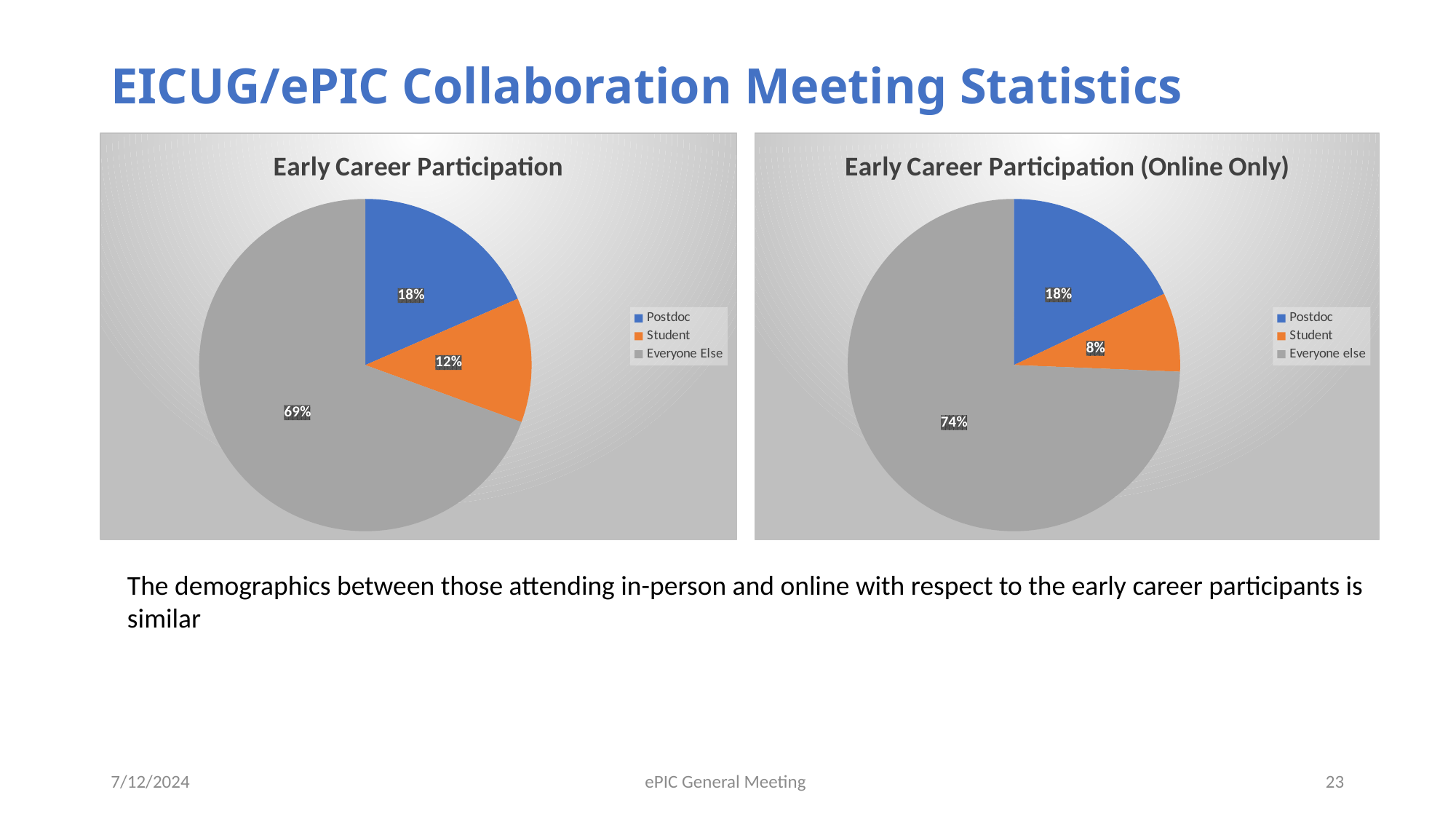
In the 'Early Career Participation' chart, what is the difference between the Postdoc and Student shares? 6% In the 'Early Career Participation' chart, what share of the pie is Student? 12% In the 'Early Career Participation (Online Only)' chart, which is larger, the Postdoc slice or the Student slice? Postdoc In the 'Early Career Participation' chart, what share of the pie is Postdoc? 18% In the 'Early Career Participation (Online Only)' chart, which category has the smallest slice? Student In the 'Early Career Participation' chart, which category has the largest slice? Everyone Else In the 'Early Career Participation (Online Only)' chart, what share of the pie is Everyone else? 74% What kind of chart is the 'Early Career Participation' chart? Pie chart How many categories does the legend of the 'Early Career Participation (Online Only)' chart list? 3